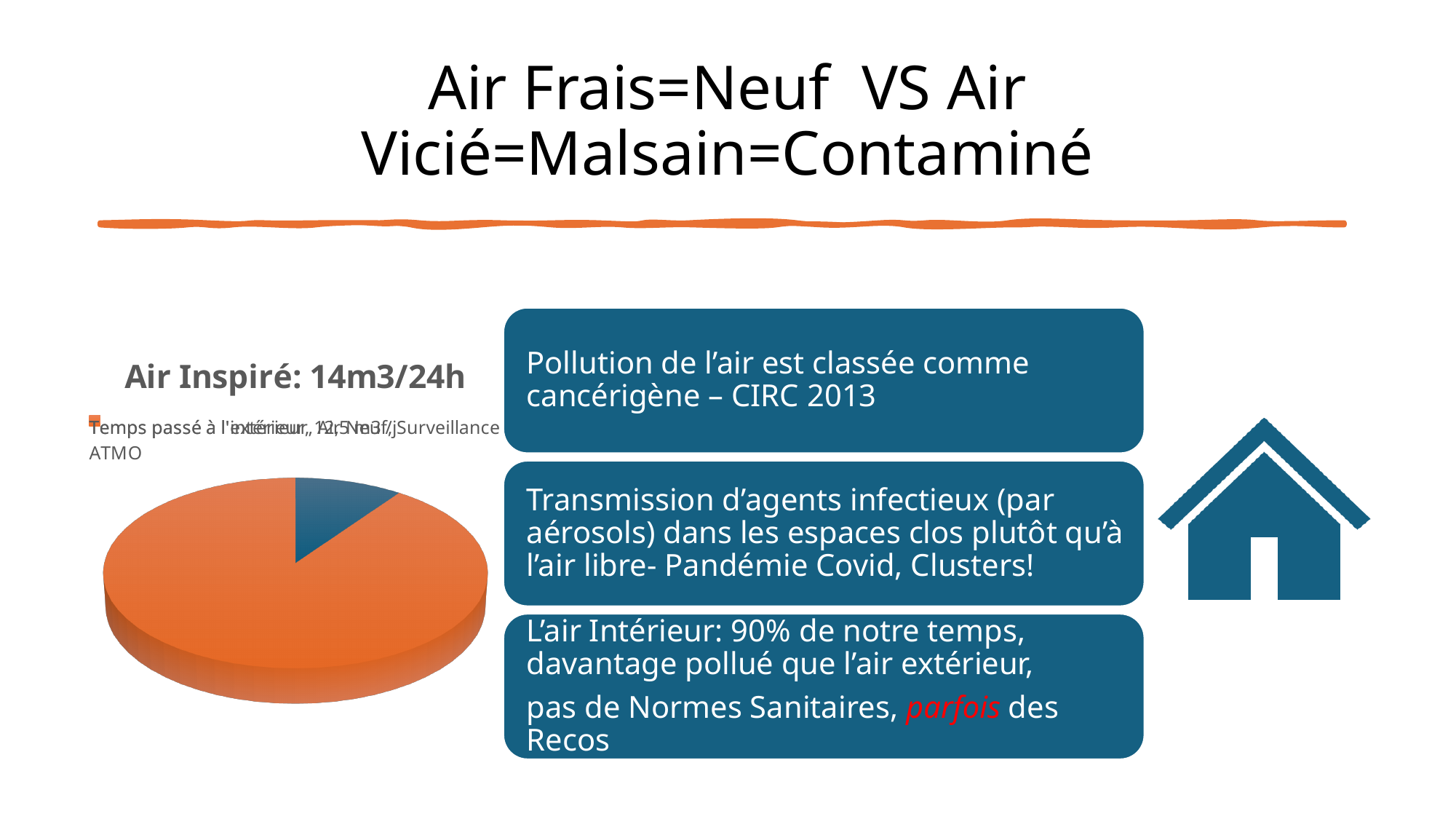
How many slices does the pie chart have? 2 What colour is the smallest slice of the pie chart? blue What kind of chart is shown on the slide? pie chart Does the orange slice of the pie chart take up more or less than half of the pie? more Which slice of the pie chart is larger, the orange one or the blue one? the orange one What is the title of the pie chart? Air Inspiré: 14m3/24h